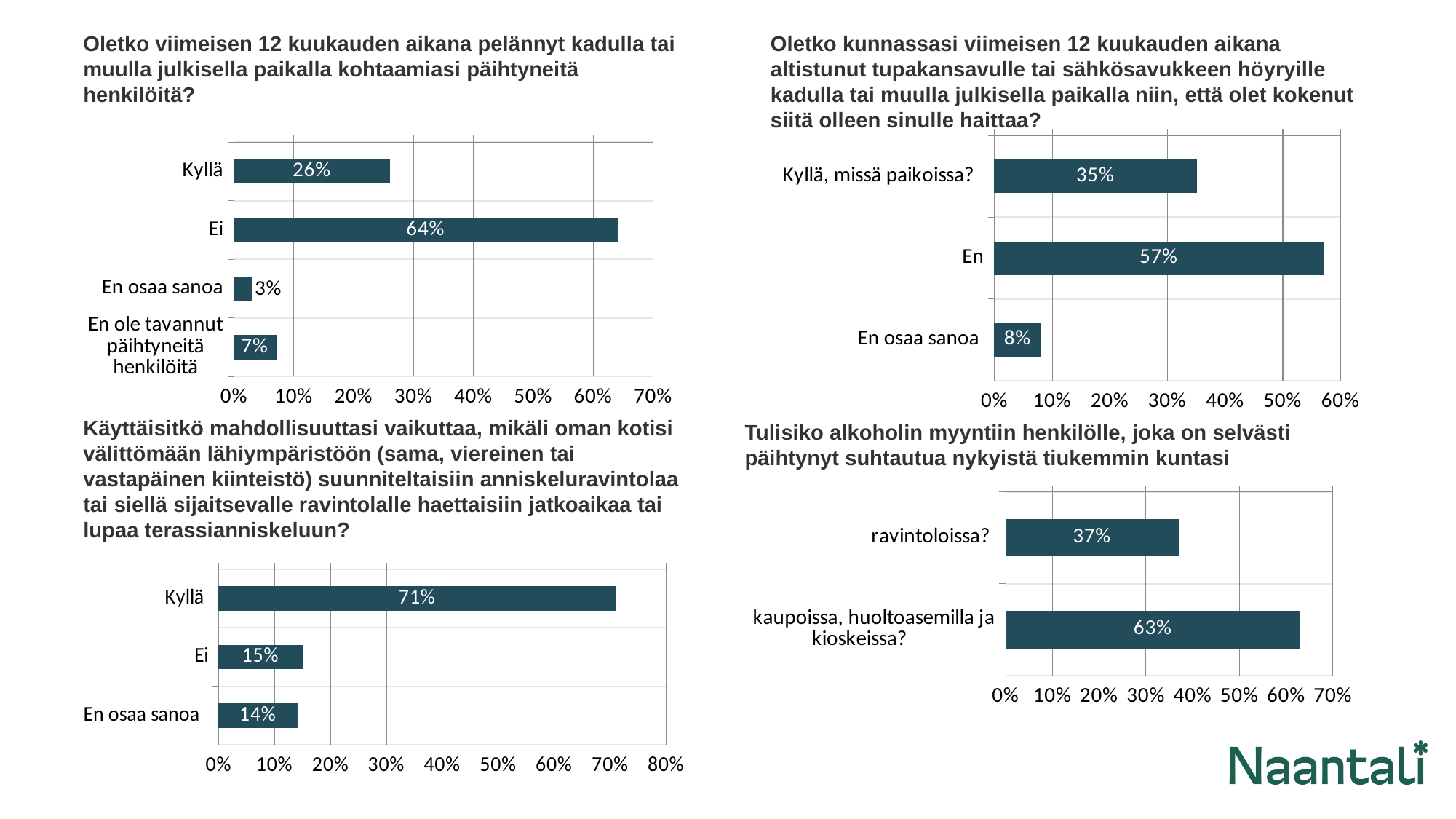
In the top-left chart, what is the difference between the values for "Ei" and "Kyllä"? 38% In the top-right chart, which category has the highest value? En What kind of chart is the bottom-right chart? Bar chart In the top-right chart, is the value for "En osaa sanoa" greater or less than 10%? less In the bottom-left chart, which is larger, the value for "Ei" or the value for "En osaa sanoa"? Ei In the bottom-right chart, what is the difference between the two values shown? 26% In the top-left chart, which category has the lowest value? En osaa sanoa In the bottom-left chart, what is the value for "Kyllä"? 71% In the bottom-right chart, what is the value for "kaupoissa, huoltoasemilla ja kioskeissa?"? 63% How many categories does the top-left chart show? 4 In the top-left chart, what is the value for "Ei"? 64% In the top-right chart, what is the value for "Kyllä, missä paikoissa?"? 35%